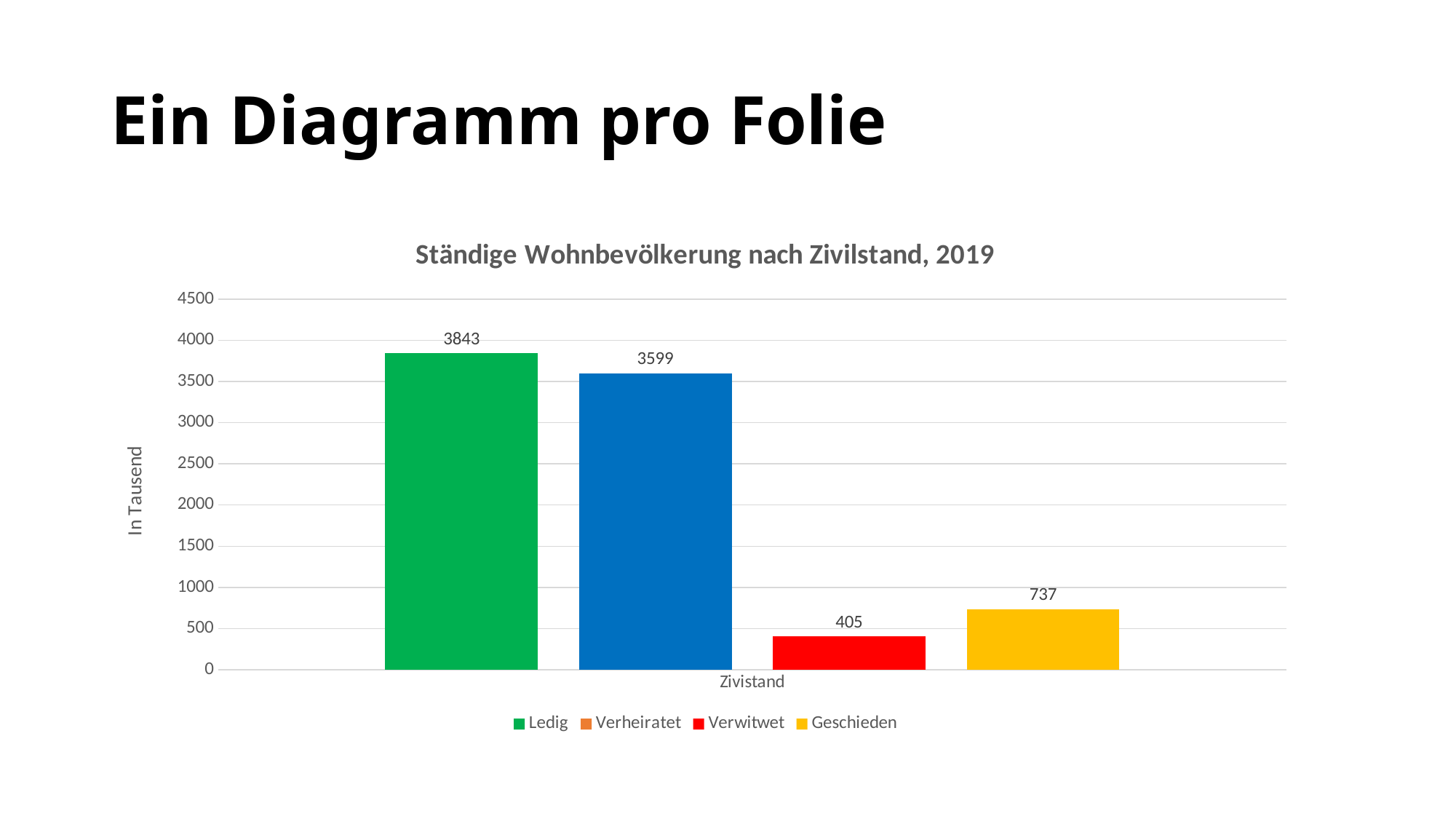
Is the value for Verheiratet greater or less than 3500? greater What is the difference between the values for Ledig and Verheiratet? 244 What is the value for Geschieden? 737 What is the value for Ledig? 3843 What is the title of the chart? Ständige Wohnbevölkerung nach Zivilstand, 2019 What is the value for Verwitwet? 405 Which is larger, the value for Geschieden or the value for Verwitwet? Geschieden What kind of chart is shown on the slide? bar chart How many series does the legend list? 4 What is the difference between the values for Geschieden and Verwitwet? 332 Which series has the highest value? Ledig Which series has the lowest value? Verwitwet